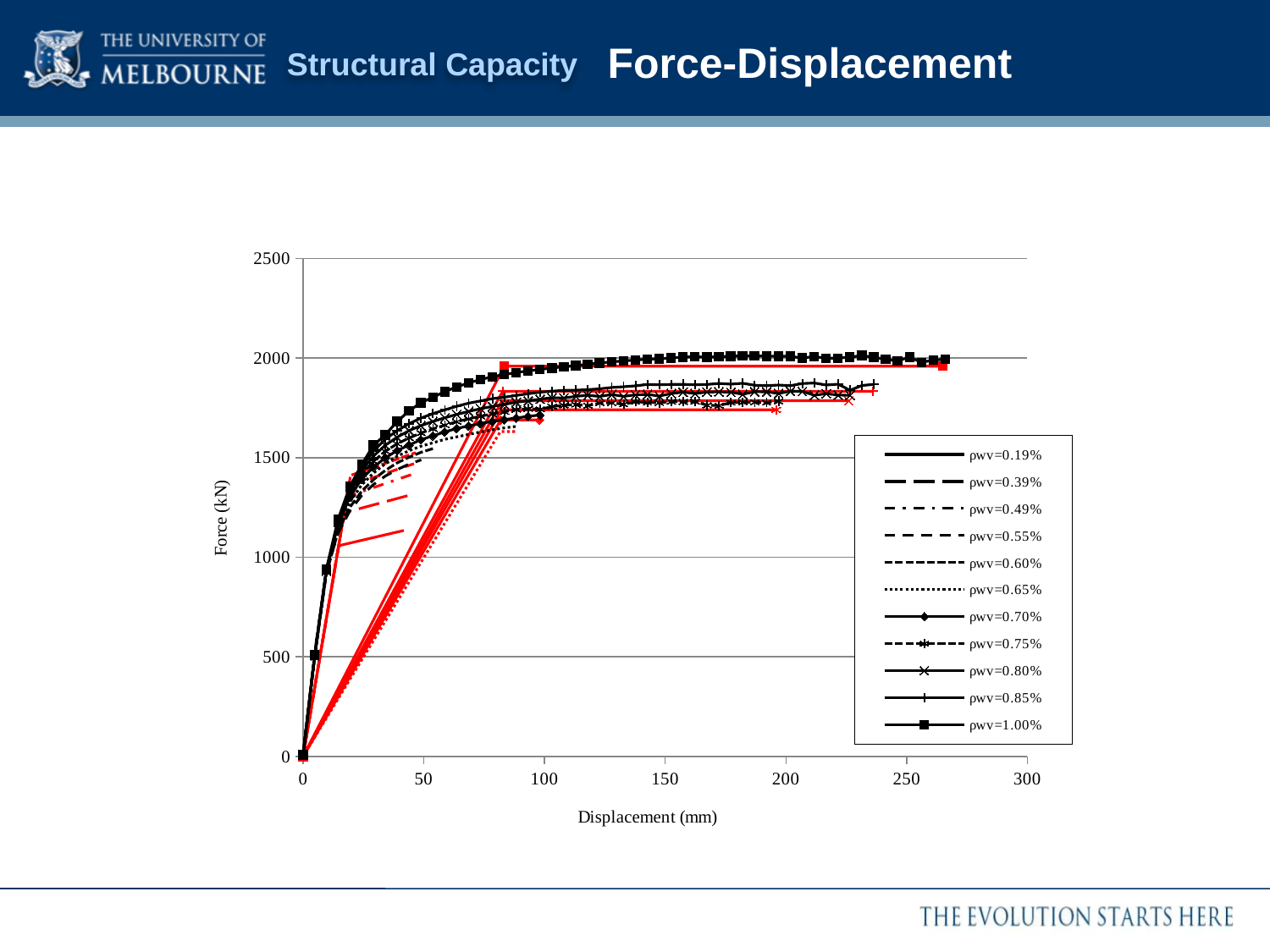
Is the largest displacement reached by the ρwv=1.00% series greater or less than 250? greater What is the label of the y axis? Force (kN) Is the peak force for the ρwv=1.00% series greater or less than 2500? less What kind of chart is shown on the slide? line chart Does the force generally rise or fall as displacement increases from 0 to 50 mm? rise What is the label of the x axis? Displacement (mm) Which series extends to the largest displacement? ρwv=1.00% Is the largest displacement reached by the ρwv=0.75% series greater or less than 150? greater Which series reaches the highest force? ρwv=1.00% Which series reaches a higher peak force, ρwv=1.00% or ρwv=0.70%? ρwv=1.00% How many series does the legend list? 11